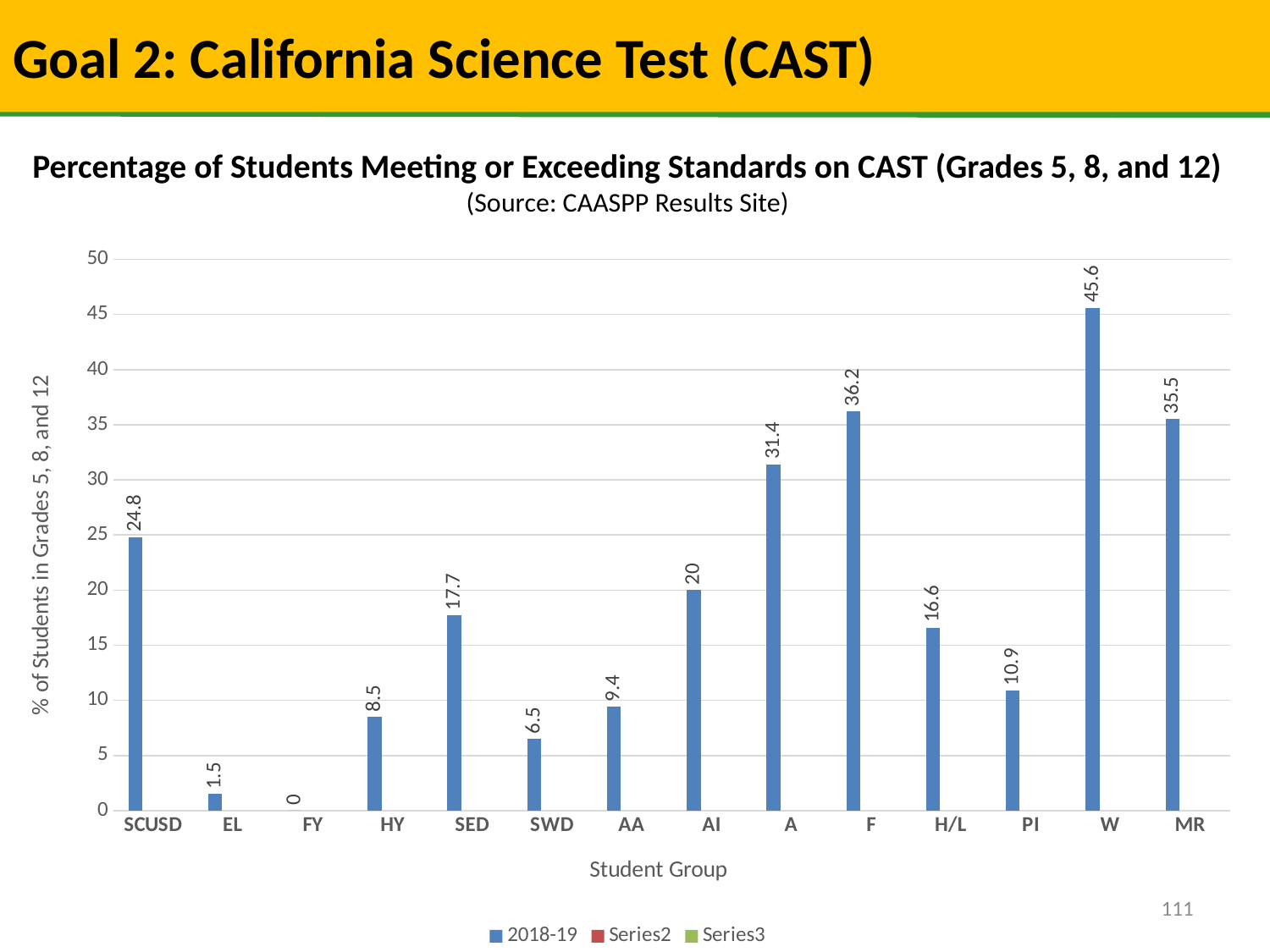
Which student group has the lowest value? FY Which is larger, the value for SED or the value for AI? AI What is the value for SCUSD? 24.8 What is the difference between the values for F and A? 4.8 How many series does the legend list? 3 What is the label of the x axis? Student Group What is the value for the W student group? 45.6 What is the value for H/L? 16.6 How many student groups are shown on the x axis? 14 What kind of chart is shown? bar chart Which student group has the highest value? W Is the value for MR greater or less than 30? greater